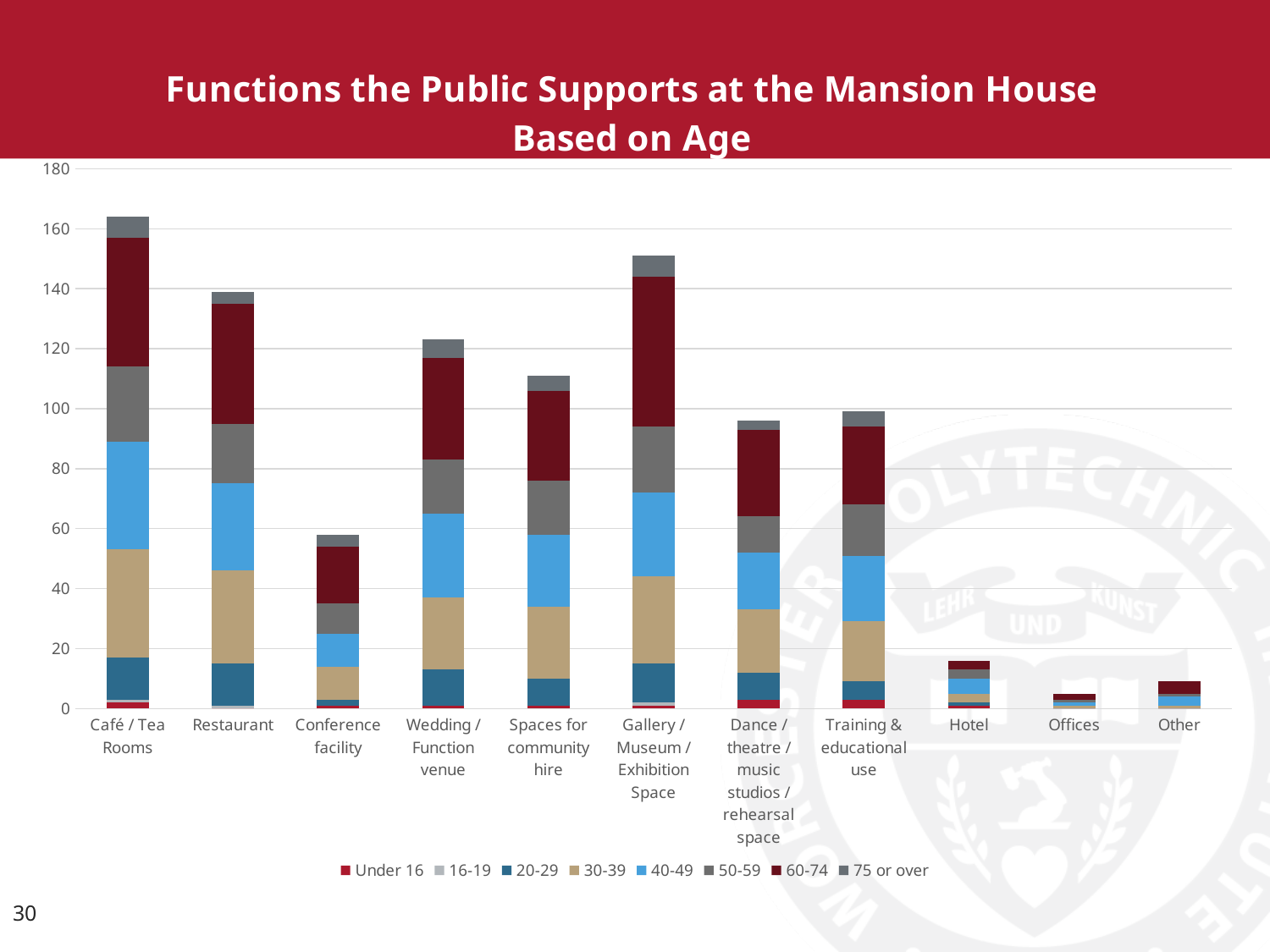
Is the total for Café / Tea Rooms greater or less than 140? greater Which function has the tallest stacked bar overall? Café / Tea Rooms How many function categories are shown along the x axis? 11 Is the total for Gallery / Museum / Exhibition Space greater or less than 140? greater Which function has the shortest stacked bar overall? Offices Is the total for Hotel greater or less than 20? less How many age groups does the legend list? 8 Which has the taller stacked bar, Restaurant or Wedding / Function venue? Restaurant What kind of chart is shown on the slide? Stacked bar chart Which has the taller stacked bar, Hotel or Other? Hotel What is the title of the chart? Functions the Public Supports at the Mansion House Based on Age